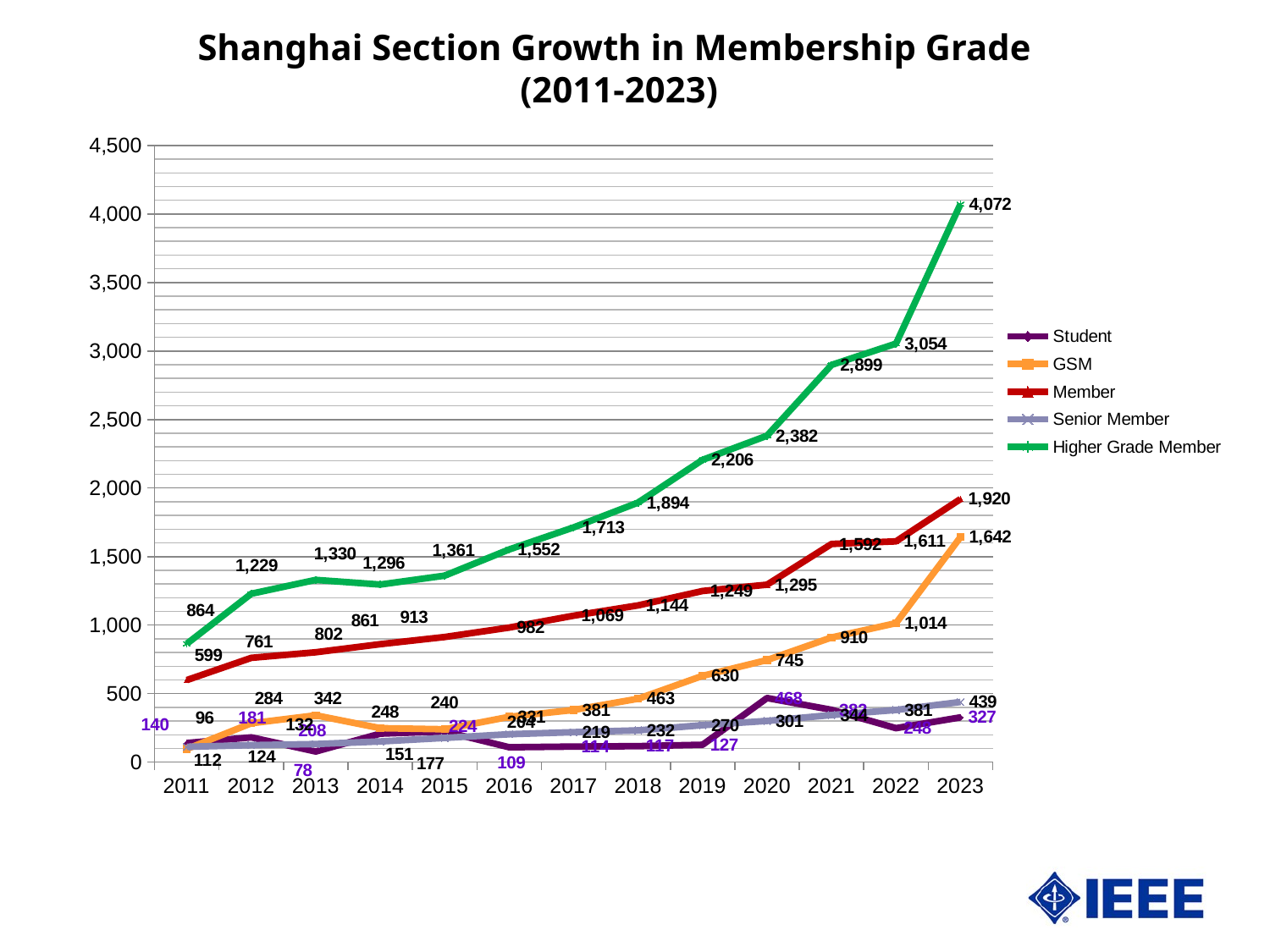
What is the value for GSM in 2023? 1,642 Which series has the highest value in 2023? Higher Grade Member In 2021, which is larger: the Member value or the GSM value? Member What is the value for Senior Member in 2023? 439 What kind of chart is shown on the slide? Line chart What is the value for Higher Grade Member in 2011? 864 By how much did the Higher Grade Member value increase from 2022 to 2023? 1,018 What is the value for Higher Grade Member in 2023? 4,072 What is the value for Member in 2023? 1,920 How many years are plotted along the x axis? 13 Does the Higher Grade Member series generally rise or fall from 2011 to 2023? Rise How many series does the legend list? 5